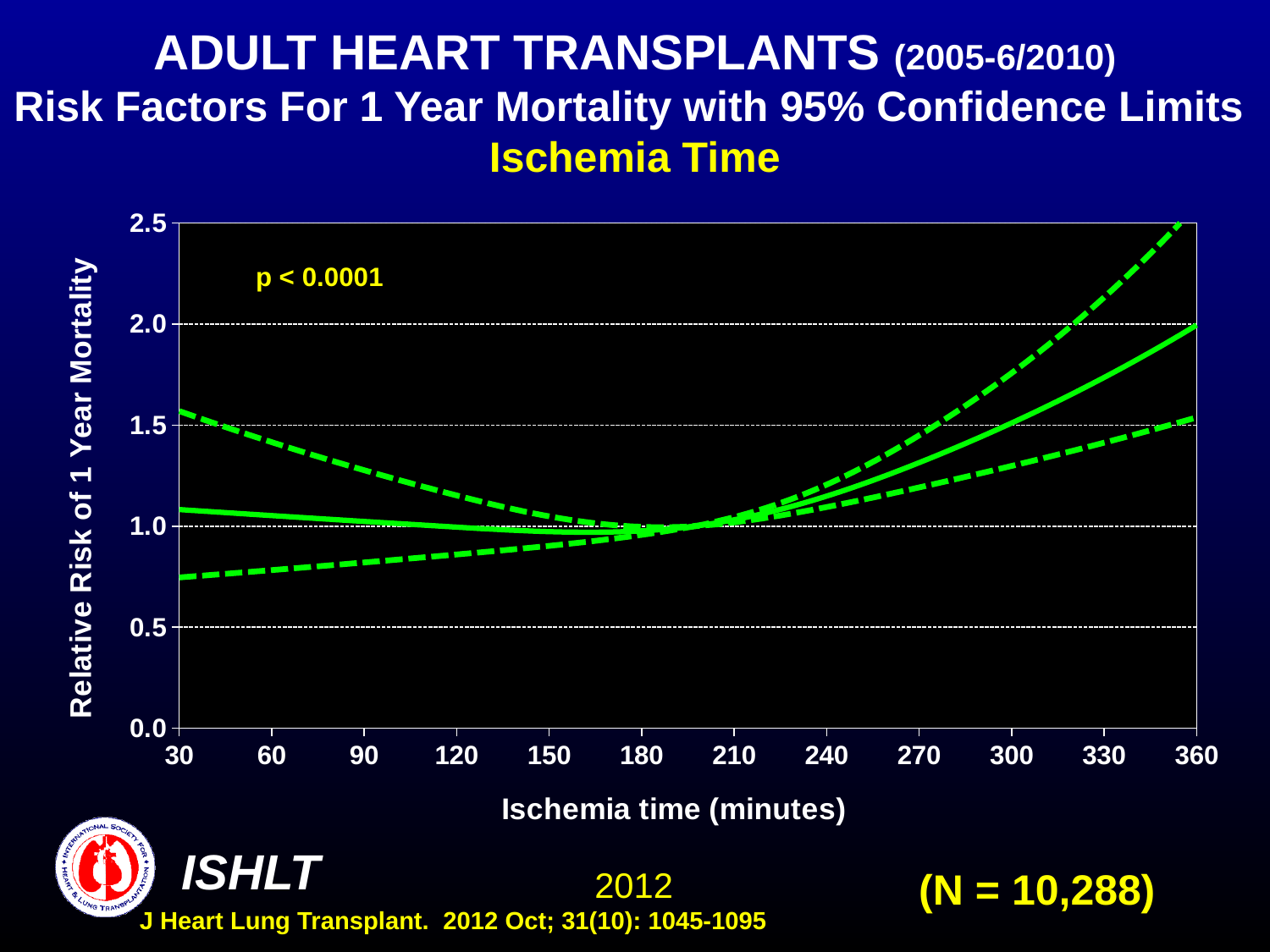
Is the value of the solid line at 330 minutes greater or less than 1.5? greater What kind of chart is shown on the slide? line chart How many tick labels are shown on the x axis (Ischemia time)? 12 Does the solid line rise or fall as ischemia time increases from 210 to 360 minutes? rise What is the sample size (N) shown on the slide? N = 10,288 Is the value of the upper dashed line at 330 minutes greater or less than 2.0? greater What p-value is printed on the chart? p < 0.0001 Is the value of the solid line at 270 minutes greater or less than 1.5? less At 360 minutes, which is higher: the solid line or the upper dashed line? the upper dashed line How many lines are plotted on the chart? 3 Does the upper dashed line rise or fall as ischemia time increases from 30 to 150 minutes? fall